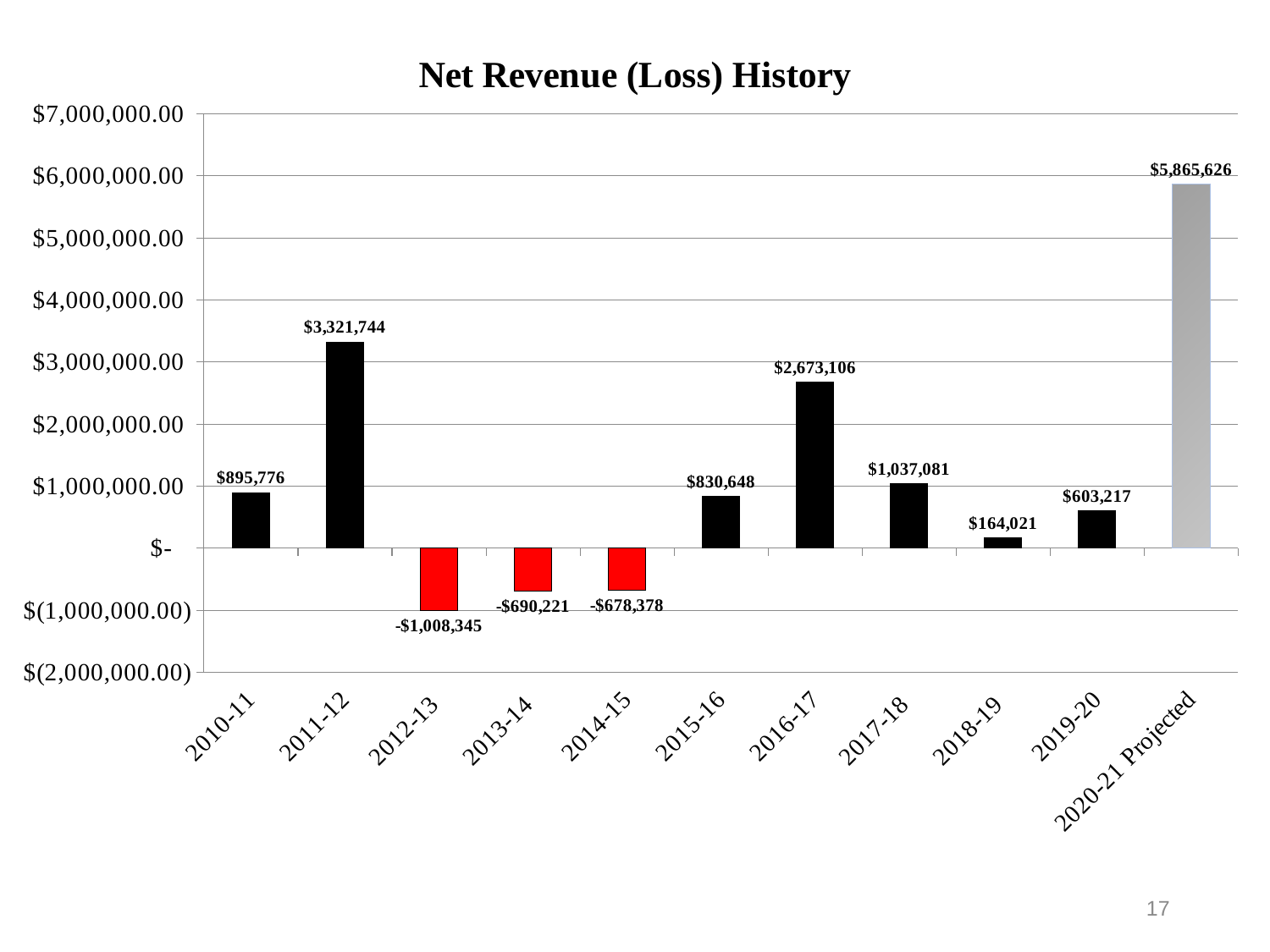
What is the value shown for 2012-13? -$1,008,345 What is the value shown for 2018-19? $164,021 What is the value shown for 2020-21 Projected? $5,865,626 What is the net revenue value for 2011-12? $3,321,744 Which year has the highest value on the chart? 2020-21 Projected What is the difference between the values for 2017-18 and 2015-16? $206,433 Which is larger, the value for 2010-11 or the value for 2015-16? 2010-11 What kind of chart is this? Bar chart Which year has the lowest value on the chart? 2012-13 What is the title of the chart? Net Revenue (Loss) History How many years (categories) are shown on the x axis? 11 What is the difference between the values for 2011-12 and 2016-17? $648,638